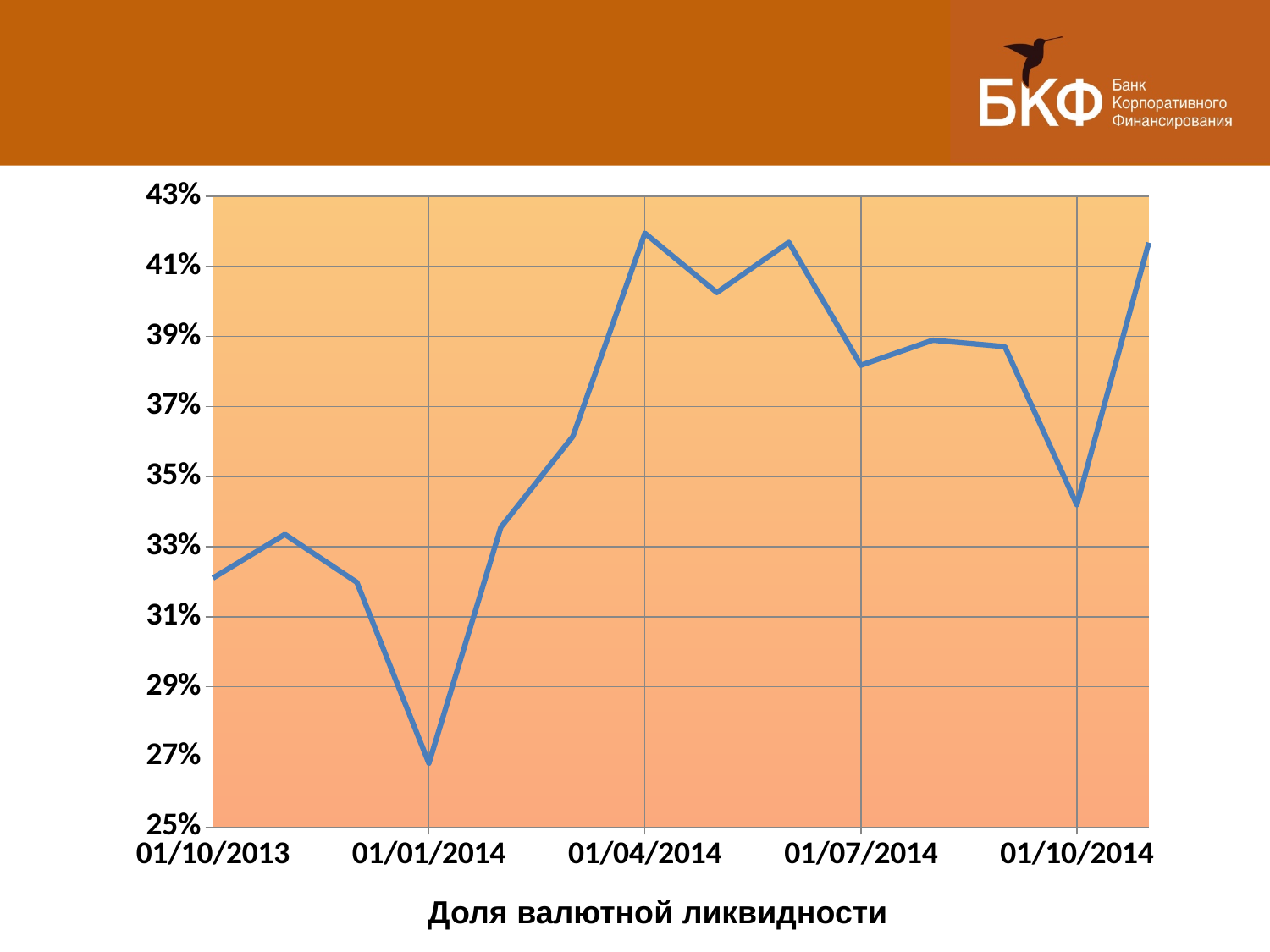
Is the value at 01/07/2014 greater or less than 37%? greater Is the value at 01/10/2013 greater or less than 31%? greater What kind of chart is shown on the slide? line chart Is the value at 01/04/2014 greater or less than 41%? greater Which is larger, the value at 01/04/2014 or the value at 01/01/2014? 01/04/2014 At which date on the x axis does the line reach its lowest value? 01/01/2014 Does the line rise or fall between 01/01/2014 and 01/04/2014? rise What is the title shown below the chart? Доля валютной ликвидности Which is larger, the value at 01/10/2013 or the value at 01/07/2014? 01/07/2014 How many date labels are shown on the x axis? 5